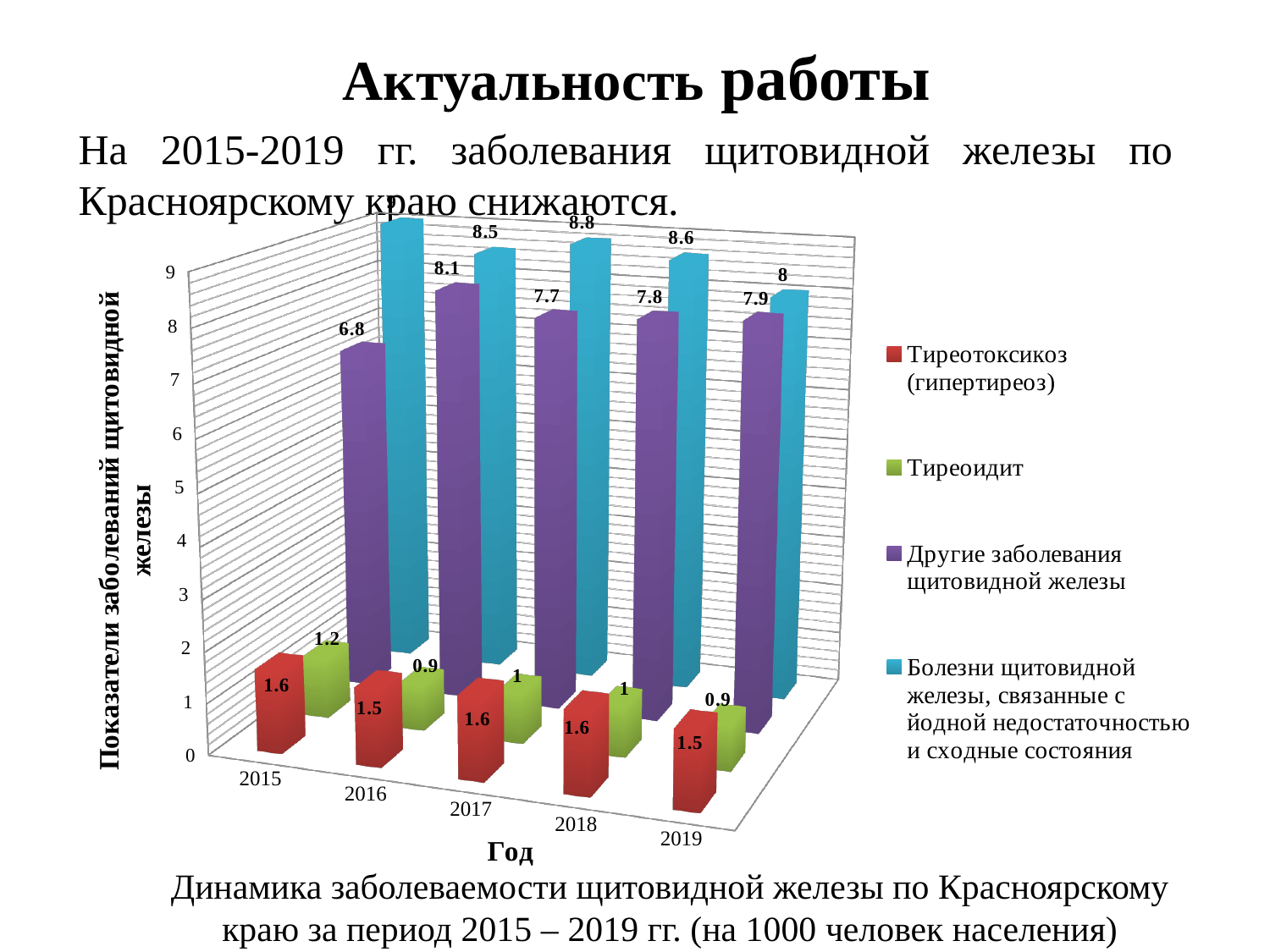
What is the value for Другие заболевания щитовидной железы in 2015? 6.8 Which is larger in 2019: the value for Другие заболевания щитовидной железы or the value for Болезни щитовидной железы, связанные с йодной недостаточностью и сходные состояния? Болезни щитовидной железы, связанные с йодной недостаточностью и сходные состояния What is the value for Болезни щитовидной железы, связанные с йодной недостаточностью и сходные состояния in 2017? 8.8 How many series does the legend list? 4 In which year is the value for Другие заболевания щитовидной железы lowest? 2015 In which year is the value for Другие заболевания щитовидной железы highest? 2016 How many years are shown on the x axis of the chart? 5 What is the title of the x axis of the chart? Год What is the value for Тиреоидит in 2015? 1.2 What type of chart is shown on the slide? bar chart What is the difference between the values for Другие заболевания щитовидной железы in 2016 and 2015? 1.3 What is the value for Тиреотоксикоз (гипертиреоз) in 2019? 1.5